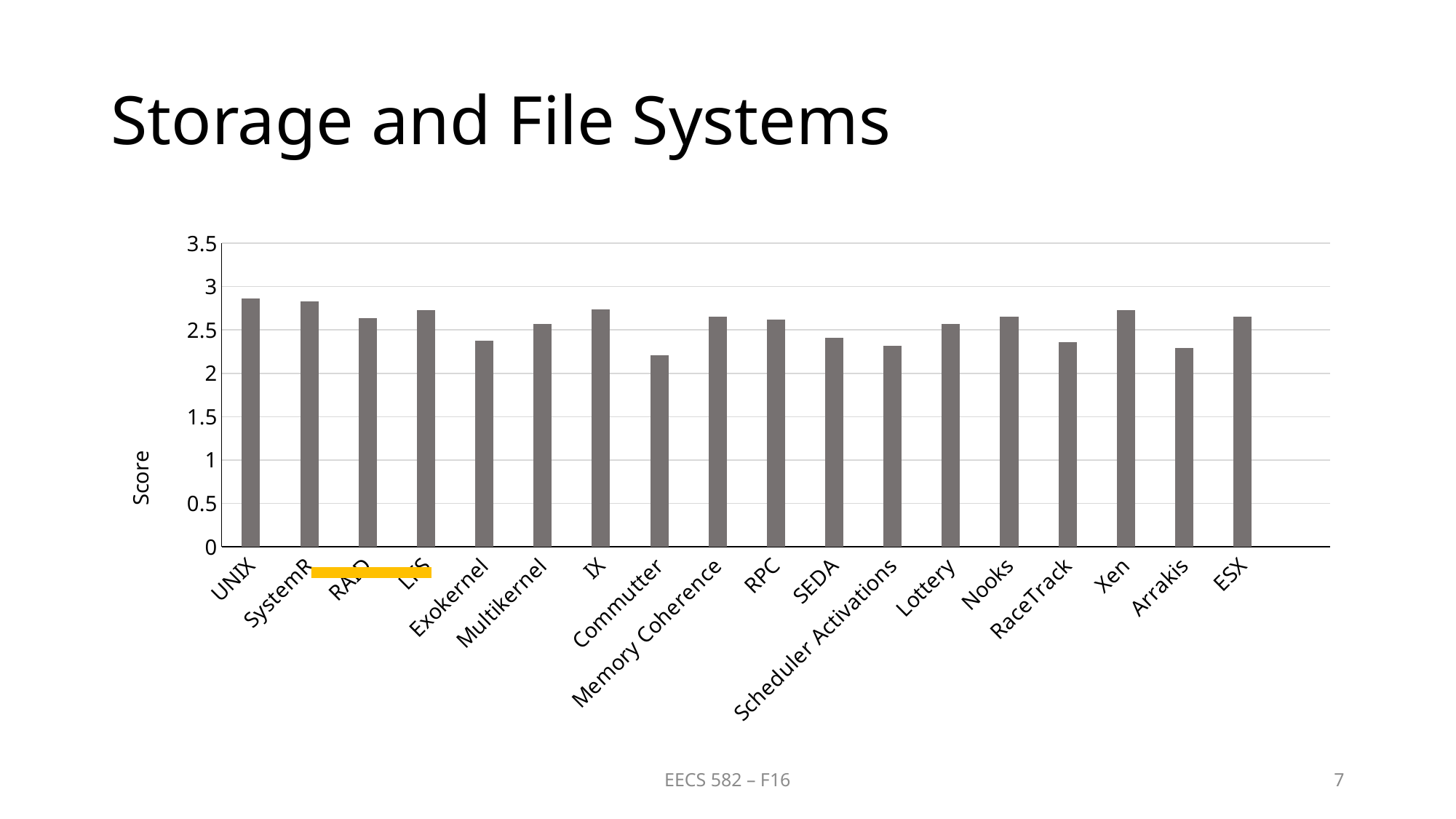
Is the value for UNIX greater or less than 2.5? greater How many bars (categories) are plotted in the chart? 18 What is the title of the slide containing the chart? Storage and File Systems Is the value for Commutter greater or less than 2.5? less Is the value for Arrakis greater or less than 2? greater Which has the larger value, UNIX or Commutter? UNIX What kind of chart is shown on the slide? bar chart Which has the larger value, Exokernel or IX? IX What is the label on the vertical axis of the chart? Score Which has the larger value, Scheduler Activations or Nooks? Nooks